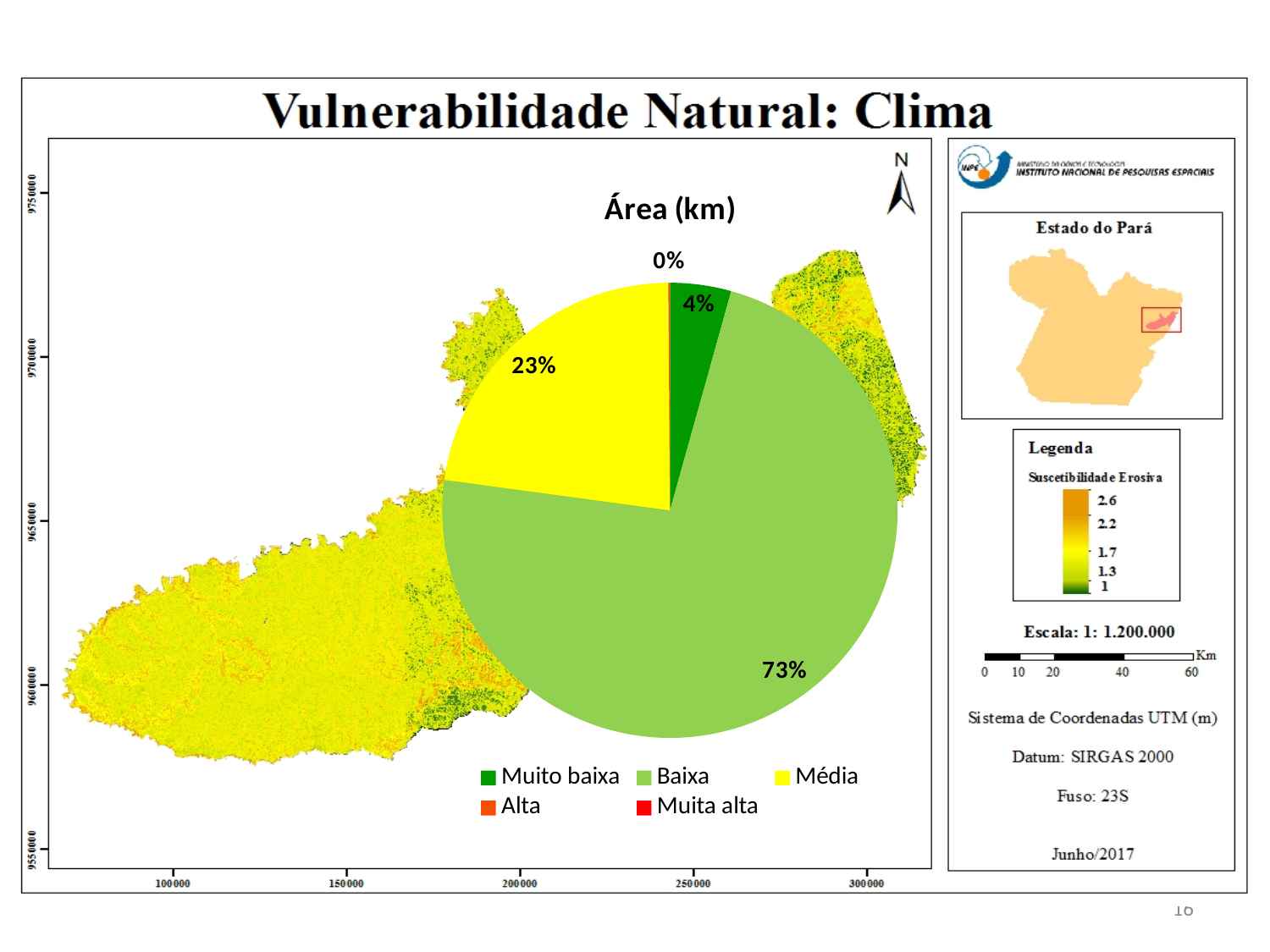
Which category has the largest slice in the pie chart? Baixa What percentage of the pie chart does the 'Muito baixa' category represent? 4% What kind of chart is shown on the slide? pie chart How many categories does the pie chart's legend list? 5 What percentage of the pie chart does the 'Baixa' category represent? 73% What colour is used for the 'Média' category in the pie chart? yellow What is the title of the pie chart? Área (km) Which slice is larger in the pie chart, 'Média' or 'Muito baixa'? Média What percentage of the pie chart does the 'Média' category represent? 23% By how many percentage points does the 'Baixa' slice exceed the 'Média' slice? 50 percentage points By how many percentage points does the 'Média' slice exceed the 'Muito baixa' slice? 19 percentage points What share of the pie chart is taken by 'Baixa'? 73%